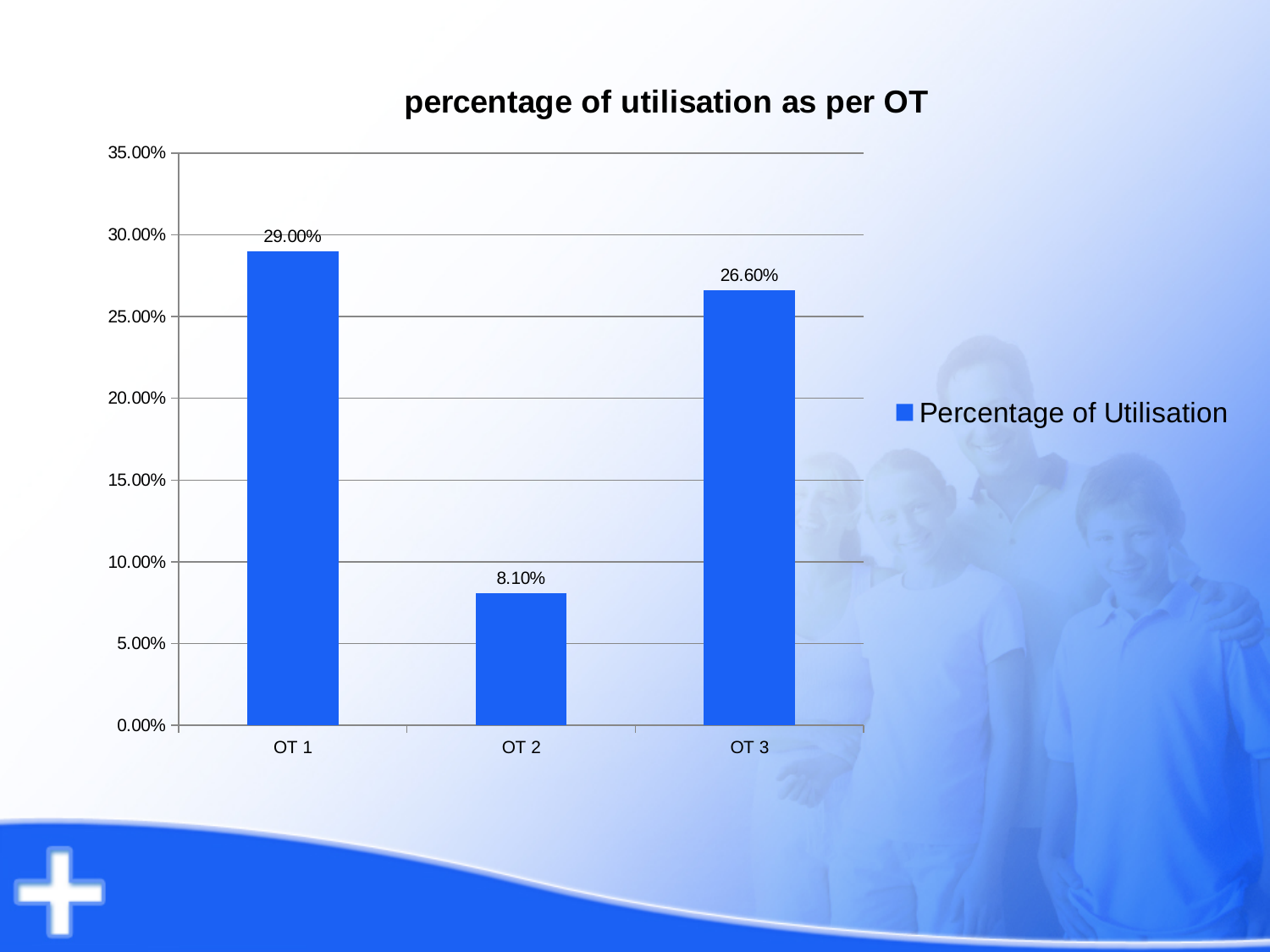
What is the difference in percentage of utilisation between OT 1 and OT 3? 2.40% What is the percentage of utilisation for OT 2? 8.10% What is the percentage of utilisation for OT 1? 29.00% What kind of chart is shown on the slide? bar chart What is the title of the chart? percentage of utilisation as per OT What is the percentage of utilisation for OT 3? 26.60% How many OTs are shown on the chart? 3 Is the value for OT 2 greater or less than 10.00%? less Which OT has the lowest percentage of utilisation? OT 2 Which has a higher percentage of utilisation, OT 2 or OT 3? OT 3 Which OT has the highest percentage of utilisation? OT 1 What is the difference in percentage of utilisation between OT 1 and OT 2? 20.90%